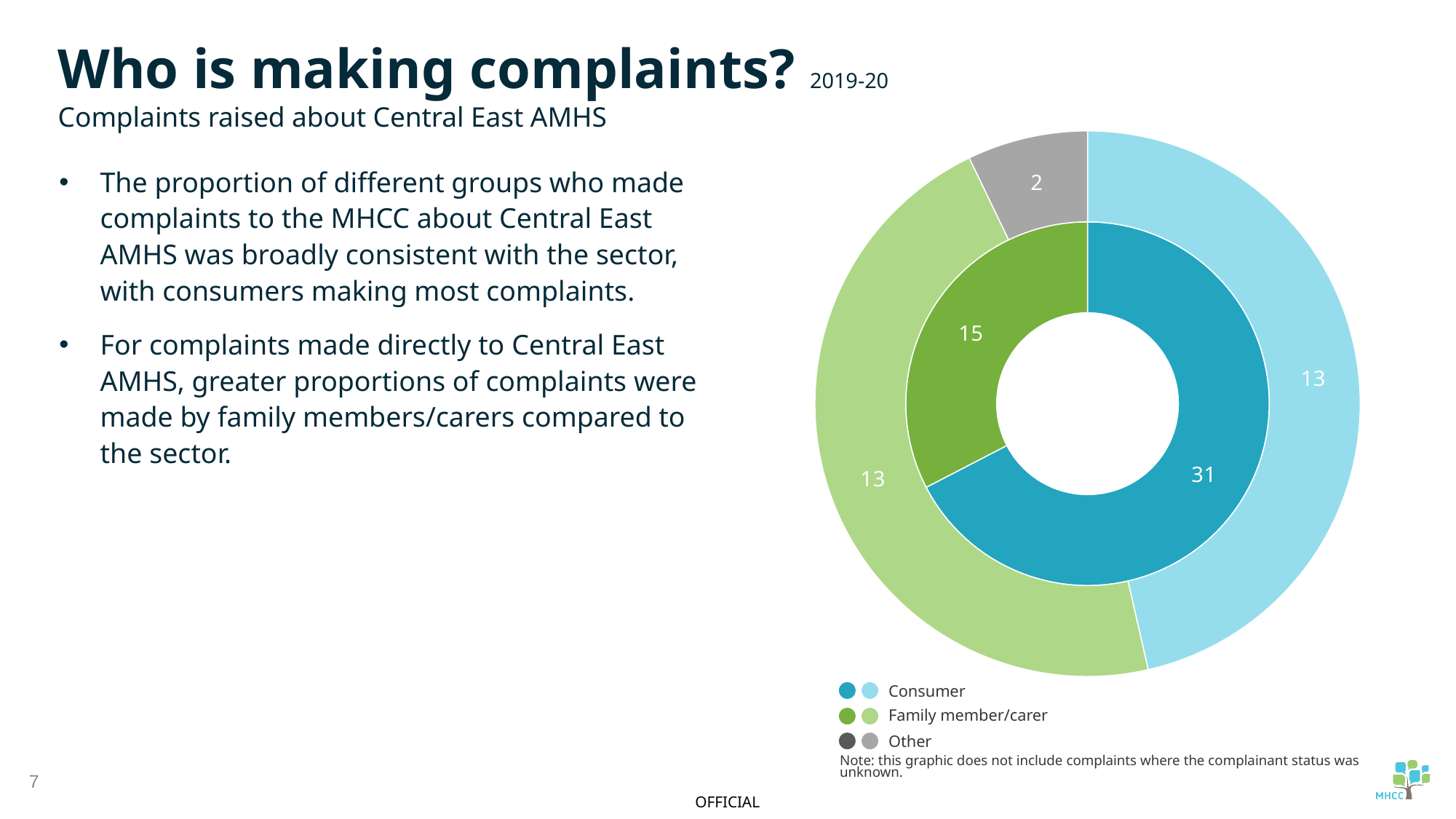
What value is shown for the Consumer segment in the inner ring? 31 How many categories does the legend list? 3 How many segments are in the outer ring? 3 What value is shown for the Other segment in the outer ring? 2 What value is shown for the Family member/carer segment in the inner ring? 15 Which category has the smallest segment in the outer ring? Other In the inner ring, what is the difference between the Consumer value and the Family member/carer value? 16 What kind of chart is shown on the slide? Doughnut chart Which category has the largest segment in the inner ring? Consumer In the inner ring, which is larger: Consumer or Family member/carer? Consumer What value is shown for the Consumer segment in the outer ring? 13 In the outer ring, what is the difference between the Family member/carer value and the Other value? 11